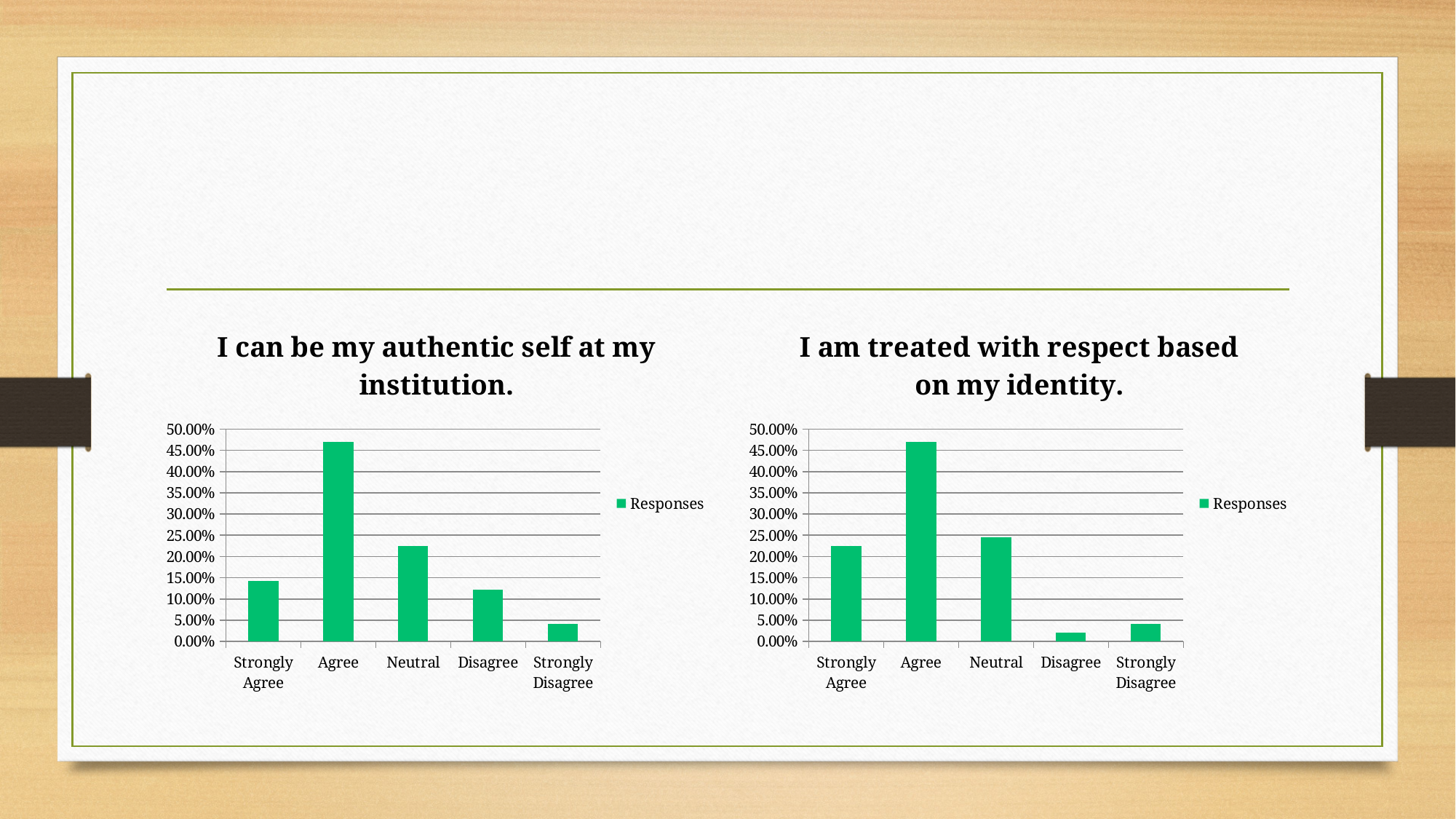
How many categories are shown on the x axis of the chart titled "I am treated with respect based on my identity."? 5 In the chart titled "I am treated with respect based on my identity.", is the value for Neutral greater or less than 20.00%? greater What kind of chart is the chart titled "I am treated with respect based on my identity."? Bar chart In the chart titled "I can be my authentic self at my institution.", which category has the highest value? Agree In the chart titled "I am treated with respect based on my identity.", is the value for Disagree greater or less than 5.00%? less In the chart titled "I am treated with respect based on my identity.", which is larger, Strongly Agree or Strongly Disagree? Strongly Agree How many series does the legend list in the chart titled "I can be my authentic self at my institution."? 1 In the chart titled "I can be my authentic self at my institution.", which category has the lowest value? Strongly Disagree In the chart titled "I can be my authentic self at my institution.", which is larger, Neutral or Disagree? Neutral In the chart titled "I can be my authentic self at my institution.", is the value for Agree greater or less than 45.00%? greater In the chart titled "I am treated with respect based on my identity.", which category has the highest value? Agree